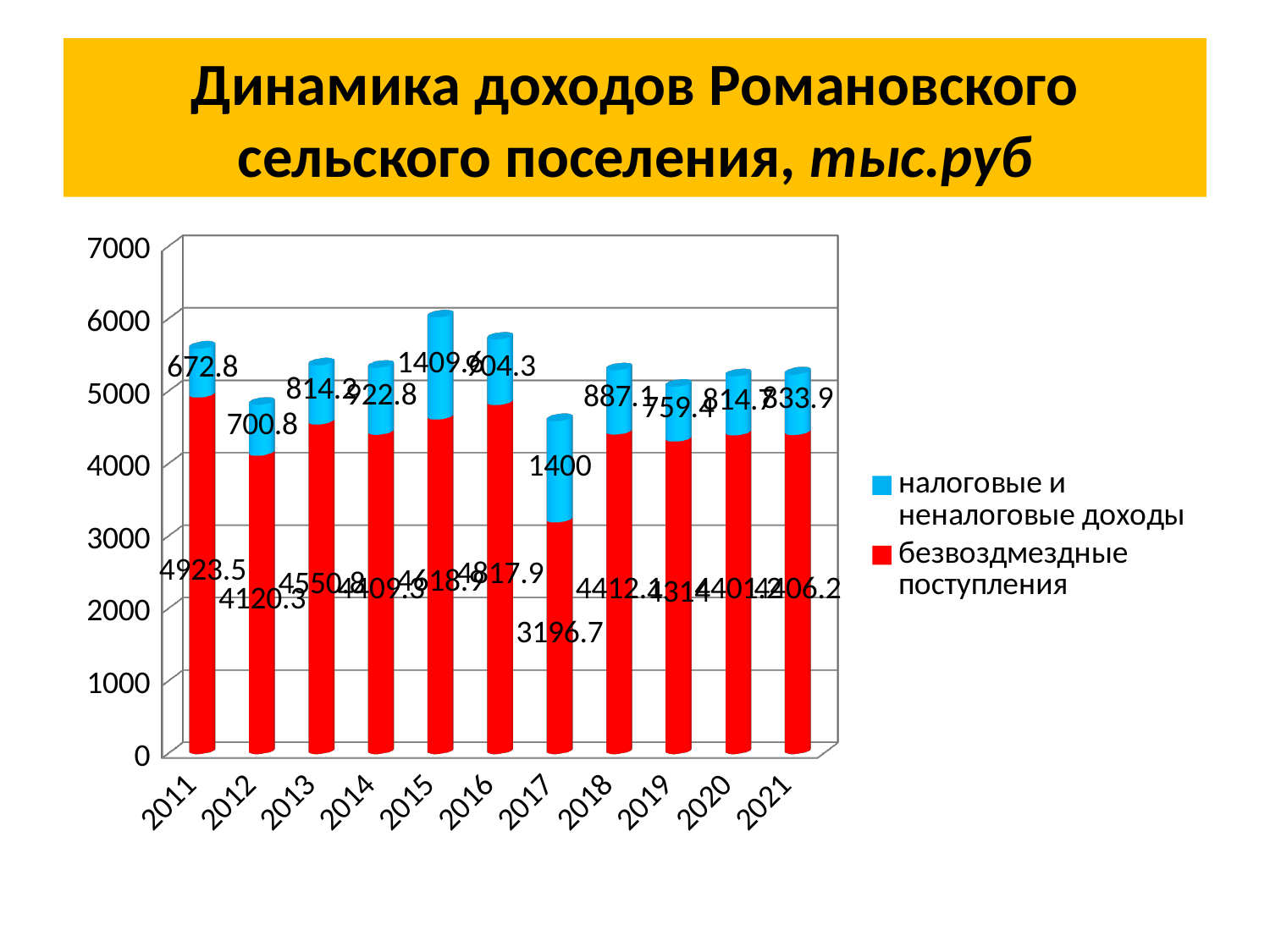
How many years are shown on the x axis? 11 Which year has the larger value of налоговые и неналоговые доходы, 2017 or 2018? 2017 What is the value of безвоздмездные поступления for 2017? 3196.7 Is the total height of the stacked bar for 2017 greater or less than 5000? less What kind of chart is shown on the slide? Stacked bar chart In which year is the value of безвоздмездные поступления the highest? 2011 How many series does the legend list? 2 What is the value of налоговые и неналоговые доходы for 2011? 672.8 What is the difference between безвоздмездные поступления in 2011 and in 2012? 803.2 In which year is the value of безвоздмездные поступления the lowest? 2017 What is the total of the stacked bar for 2017? 4596.7 What is the value of безвоздмездные поступления for 2012? 4120.3